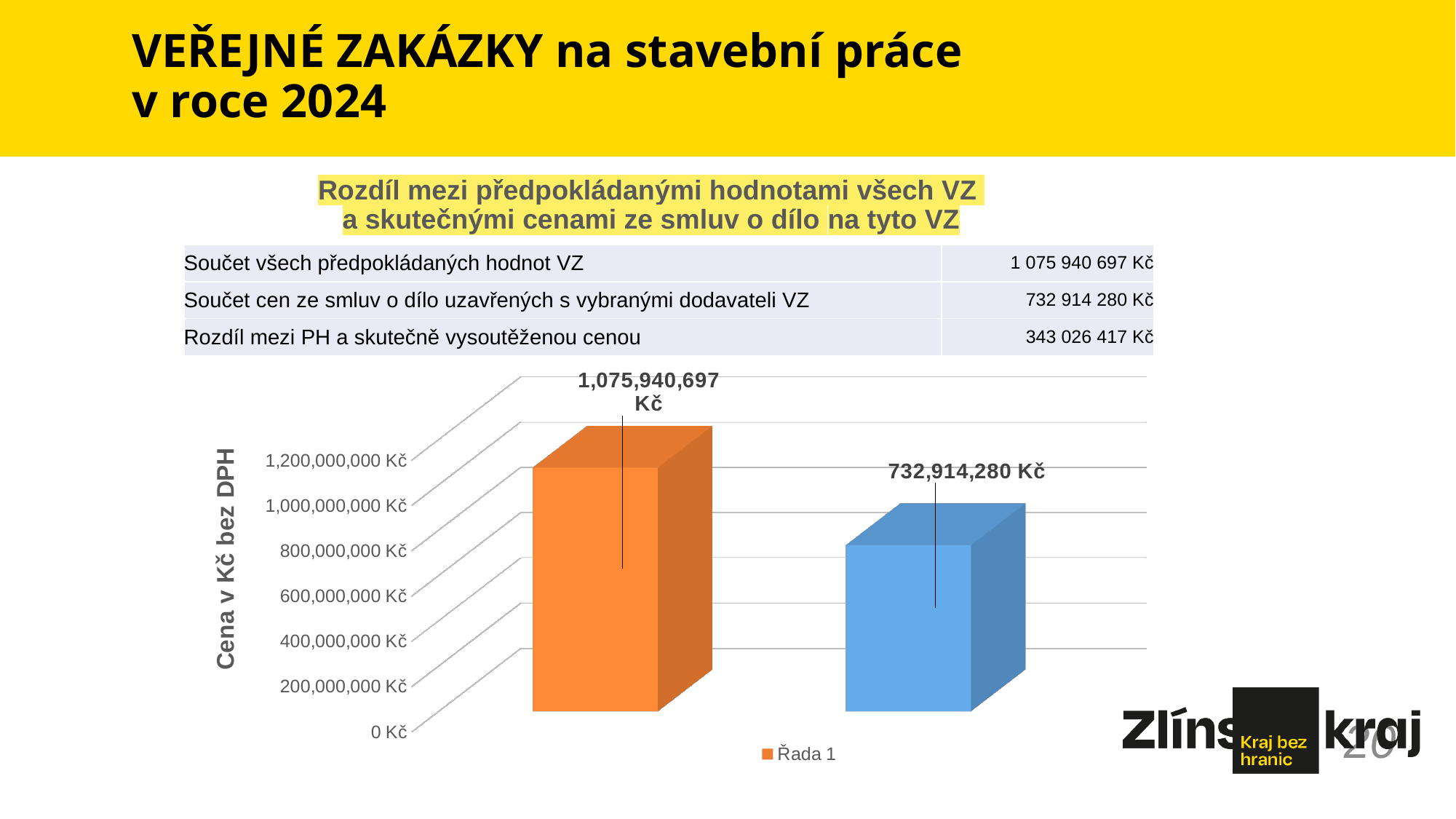
Is the value of the orange (left) bar greater or less than 1,000,000,000 Kč? greater What value is labelled on the orange (left) bar? 1,075,940,697 Kč What value is labelled on the blue (right) bar? 732,914,280 Kč How many bars are plotted in the chart? 2 How many series does the chart legend list? 1 Which bar is the tallest in the chart? The orange (left) bar Which is larger: the value of the orange bar or the value of the blue bar? The orange bar Which bar is the shortest in the chart? The blue (right) bar What type of chart is shown on the slide? Bar chart What is the difference between the orange bar's value and the blue bar's value? 343,026,417 Kč What is the title of the vertical axis of the chart? Cena v Kč bez DPH Is the value of the blue (right) bar greater or less than 800,000,000 Kč? less